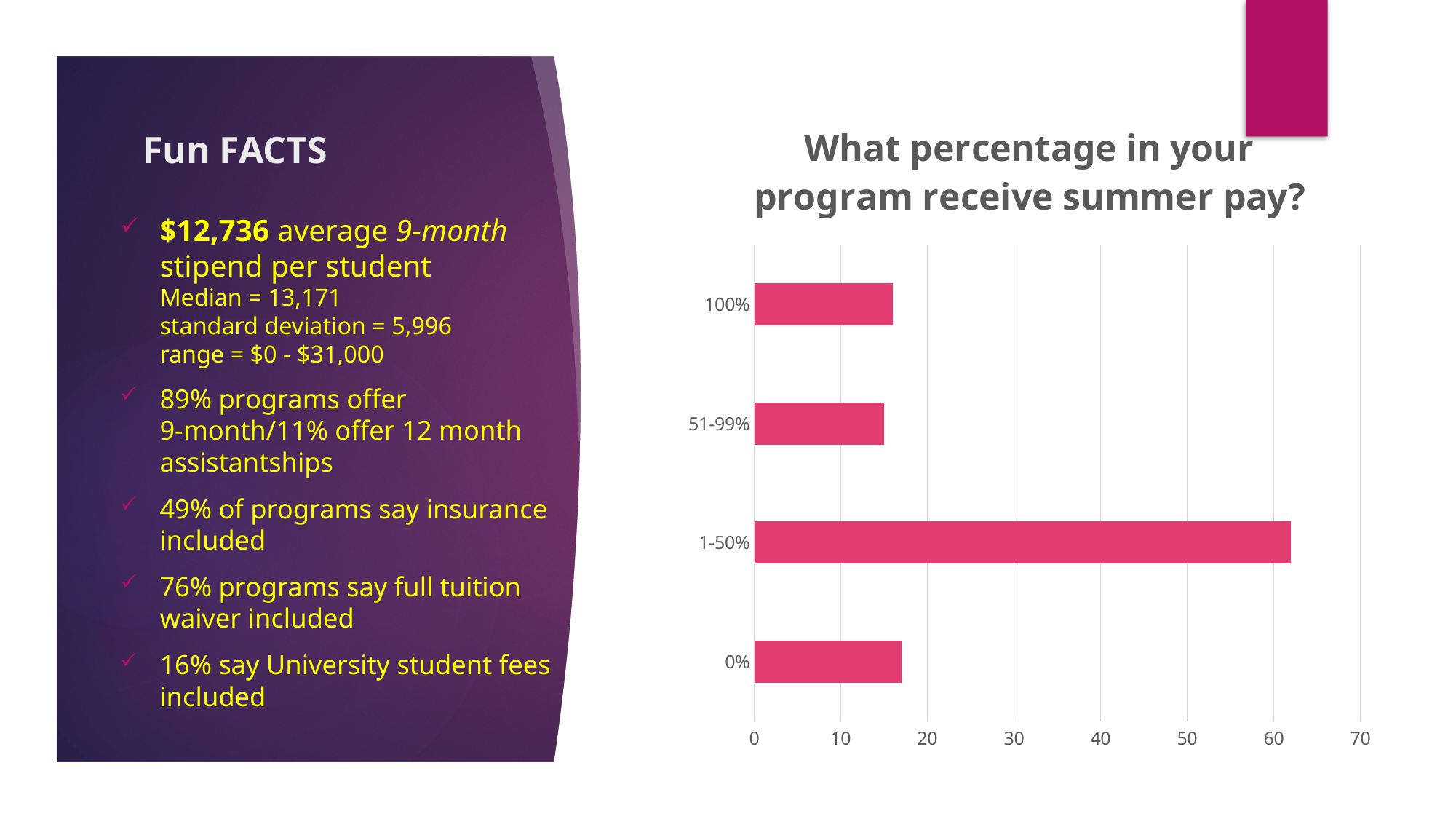
Which category has the highest value in the chart? 1-50% Is the value for 100% greater or less than 20? less What is the highest value shown on the horizontal axis of the chart? 70 Is the value for 51-99% greater or less than 20? less Is the value for 0% greater or less than 20? less Which has a larger value, 51-99% or 1-50%? 1-50% Which has a larger value, 1-50% or 100%? 1-50% What is the title of the chart? What percentage in your program receive summer pay? What kind of chart is shown on the slide? bar chart How many categories are plotted in the chart? 4